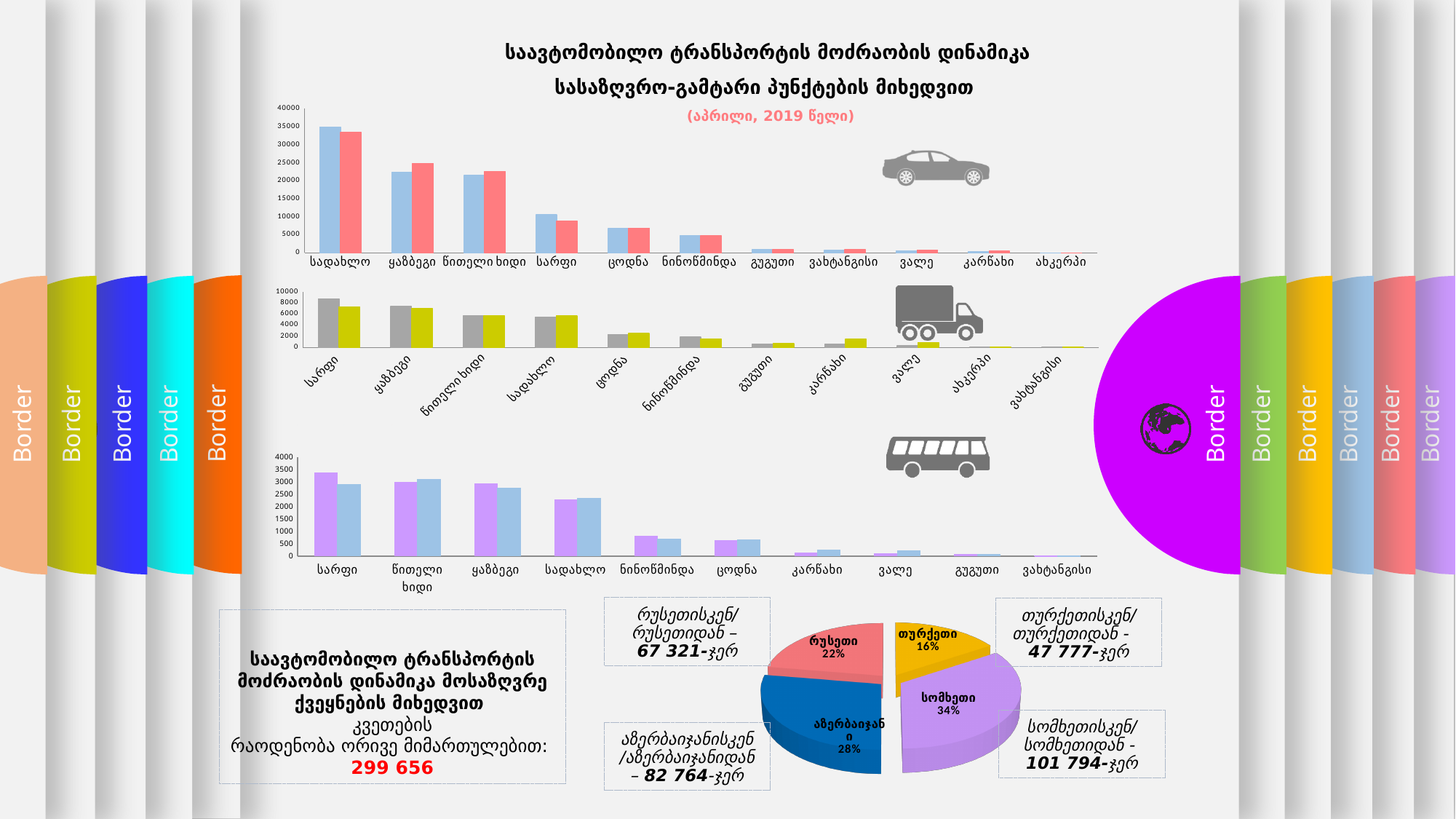
In the top bar chart (with the car icon), which category has the highest values? სადახლო In the pie chart at the bottom of the slide, how many percentage points larger is the სომხეთი slice than the რუსეთი slice? 12 In the pie chart at the bottom of the slide, how many slices are there? 4 In the pie chart at the bottom of the slide, which slice is the smallest? თურქეთი In the pie chart at the bottom of the slide, what share is shown for სომხეთი? 34% In the pie chart at the bottom of the slide, what share is shown for თურქეთი? 16% In the pie chart at the bottom of the slide, what share is shown for რუსეთი? 22% What kind of chart is the chart with the truck icon in the middle of the slide? bar chart How many categories are shown on the x axis of the bottom bar chart (with the bus icon)? 10 In the pie chart at the bottom of the slide, which slice is the largest? სომხეთი In the bottom bar chart (with the bus icon), is the value of the first (purple) bar for სარფი greater or less than 3000? greater In the top bar chart (with the car icon), is the value of the first (blue) bar for სადახლო greater or less than 30000? greater